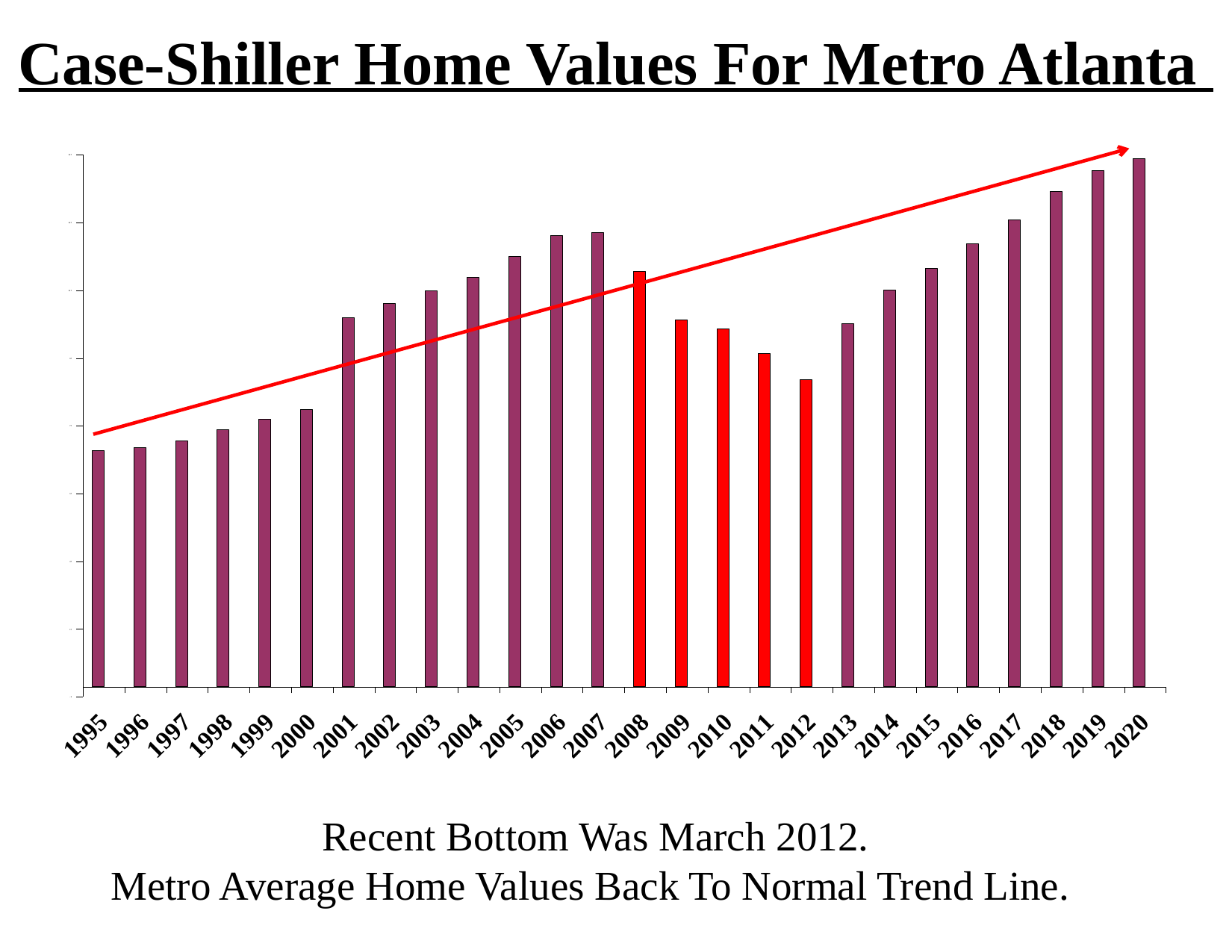
Which year has the higher value, 2007 or 2012? 2007 Which years are shown with bright red bars in the chart? 2008, 2009, 2010, 2011, 2012 Which year has the highest home value in the chart? 2020 Do the values rise or fall from 2012 to 2020? Rise Do the values rise or fall from 2008 to 2012? Fall Do the values rise or fall from 1995 to 2007? Rise Which year has the higher value, 2012 or 2013? 2013 Which year has the higher value, 2019 or 2020? 2020 How many years are plotted on the x axis of the chart? 26 What kind of chart is shown on the slide? Bar chart What is the title of the chart on the slide? Case-Shiller Home Values For Metro Atlanta